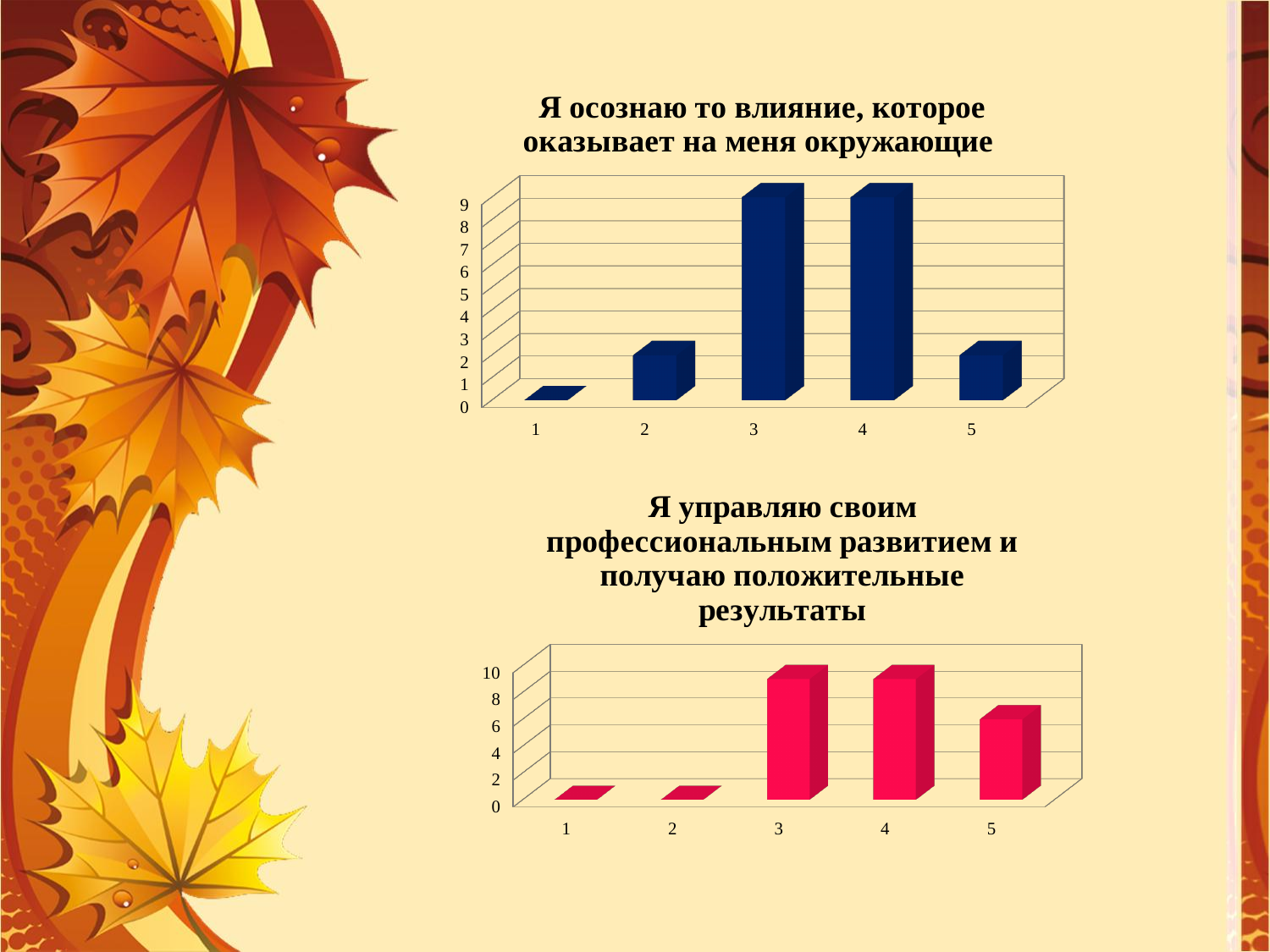
In the bottom chart ("Я управляю своим профессиональным развитием..."), is the value for category 1 greater or less than 2? less What colour are the bars in the bottom chart ("Я управляю своим профессиональным развитием...")? red In the top chart ("Я осознаю то влияние..."), which has the larger value, category 3 or category 5? 3 In the bottom chart ("Я управляю своим профессиональным развитием..."), is the value for category 4 greater or less than 8? greater In the top chart ("Я осознаю то влияние..."), which category has the lowest value? 1 In the bottom chart ("Я управляю своим профессиональным развитием..."), how many categories are shown on the x axis? 5 In the top chart ("Я осознаю то влияние..."), is the value for category 2 greater or less than 5? less What type of chart is shown under the title "Я осознаю то влияние, которое оказывает на меня окружающие"? bar chart In the top chart ("Я осознаю то влияние..."), how many categories are shown on the x axis? 5 In the bottom chart ("Я управляю своим профессиональным развитием..."), which has the larger value, category 3 or category 5? 3